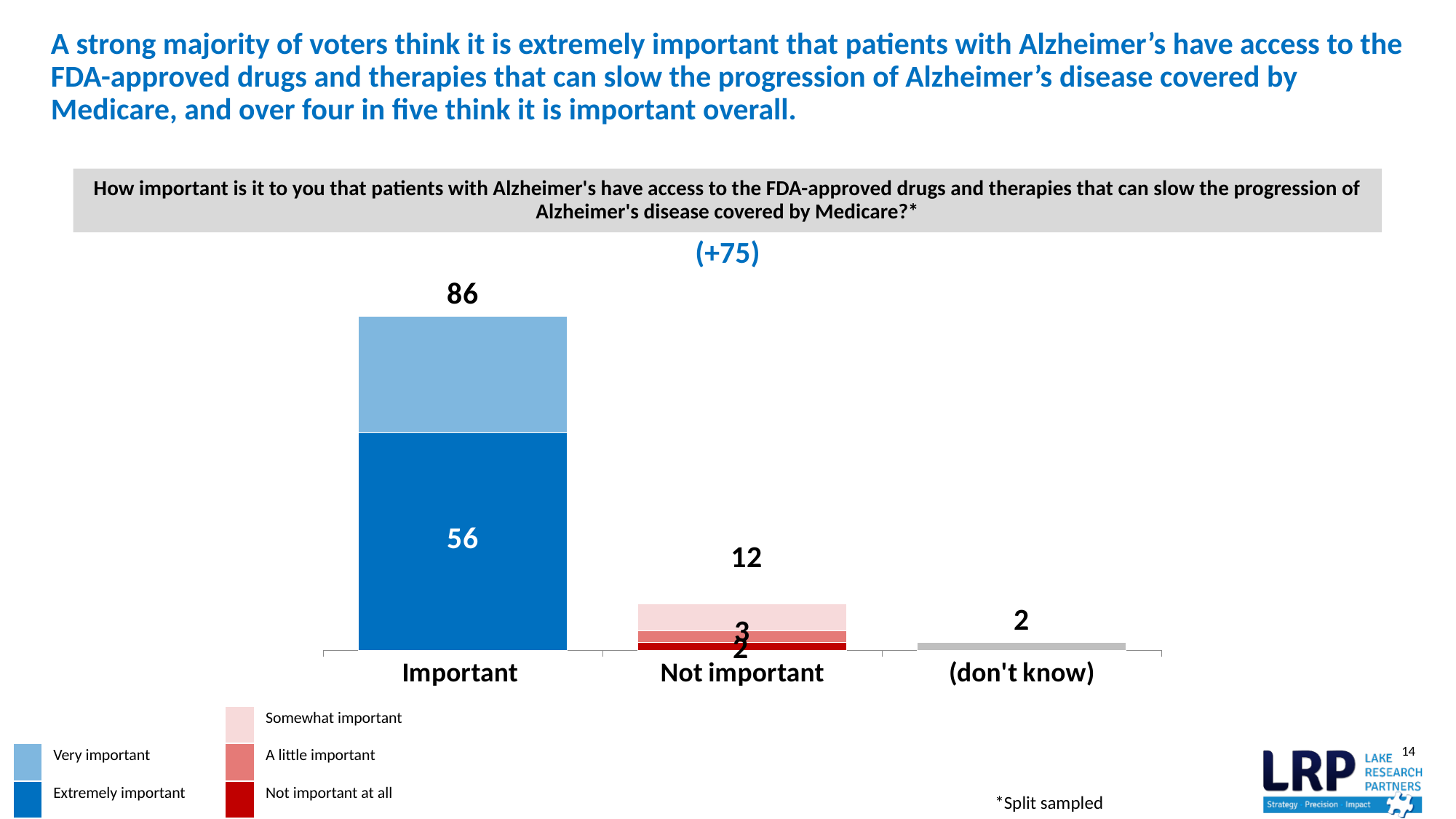
How many categories are shown on the x axis? 3 Which category has the highest total value? Important Which category has the lowest total value? (don't know) What value is shown for the Not important at all segment? 2 What value is shown for the (don't know) category? 2 What is the total value shown for the Important bar? 86 What value is shown for the A little important segment? 3 What is the total value shown for the Not important bar? 12 What is the difference between the Important total and the Not important total? 74 What net figure is printed above the chart in blue? (+75) What value is shown for the Extremely important segment of the Important bar? 56 How many entries does the legend list? 5